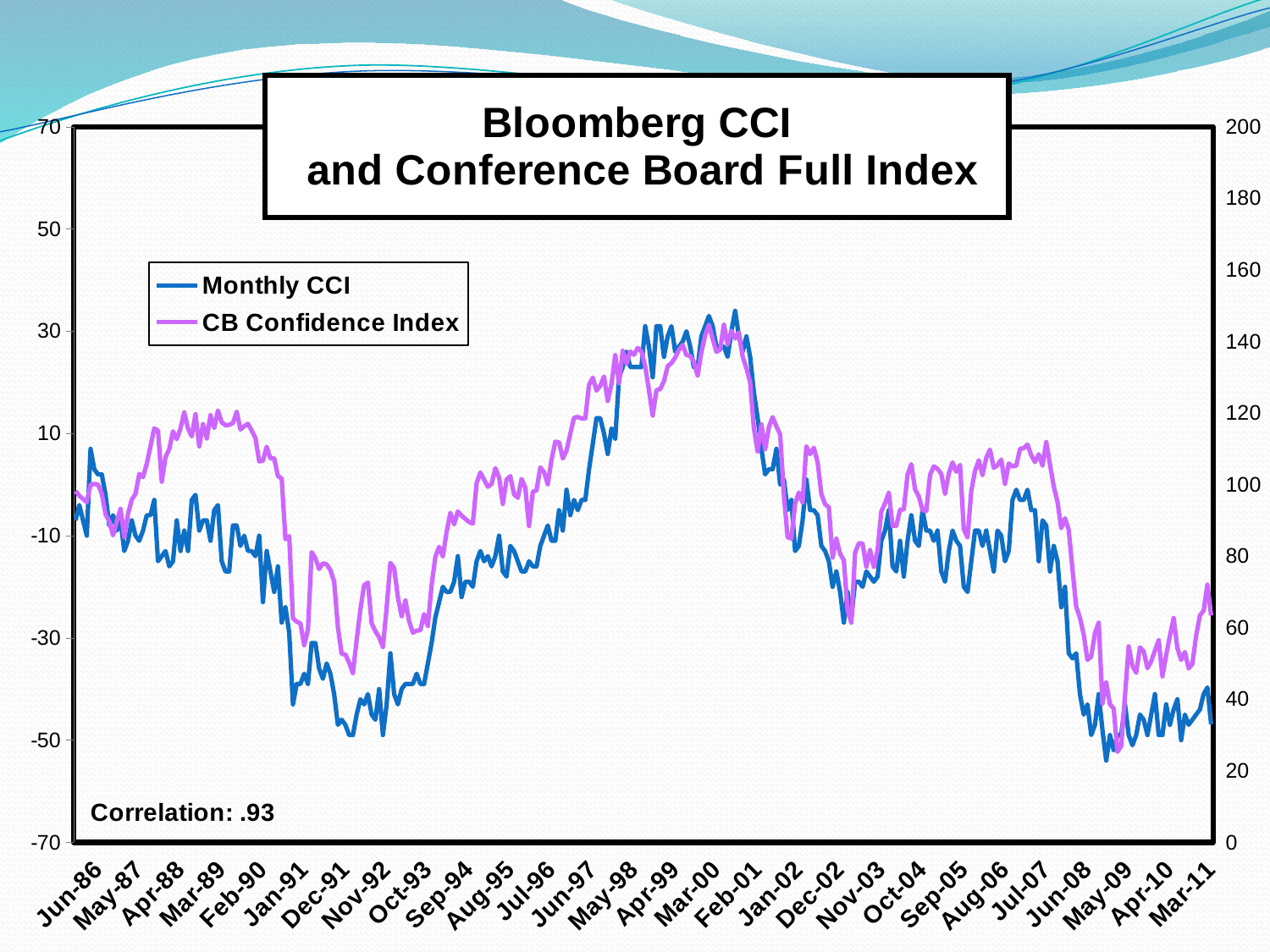
Is the Monthly CCI value around Mar-00 greater or less than 10? greater How many series does the legend list? 2 What correlation value is printed on the chart? .93 What is the title of the chart? Bloomberg CCI and Conference Board Full Index Is the CB Confidence Index value around Jul-07 greater or less than 100? greater What kind of chart is shown on the slide? line chart Between Jul-07 and May-09, do the Monthly CCI values rise or fall? fall Between Jun-97 and Mar-00, do the CB Confidence Index values rise or fall? rise Is the Monthly CCI value around Dec-91 greater or less than -30? less